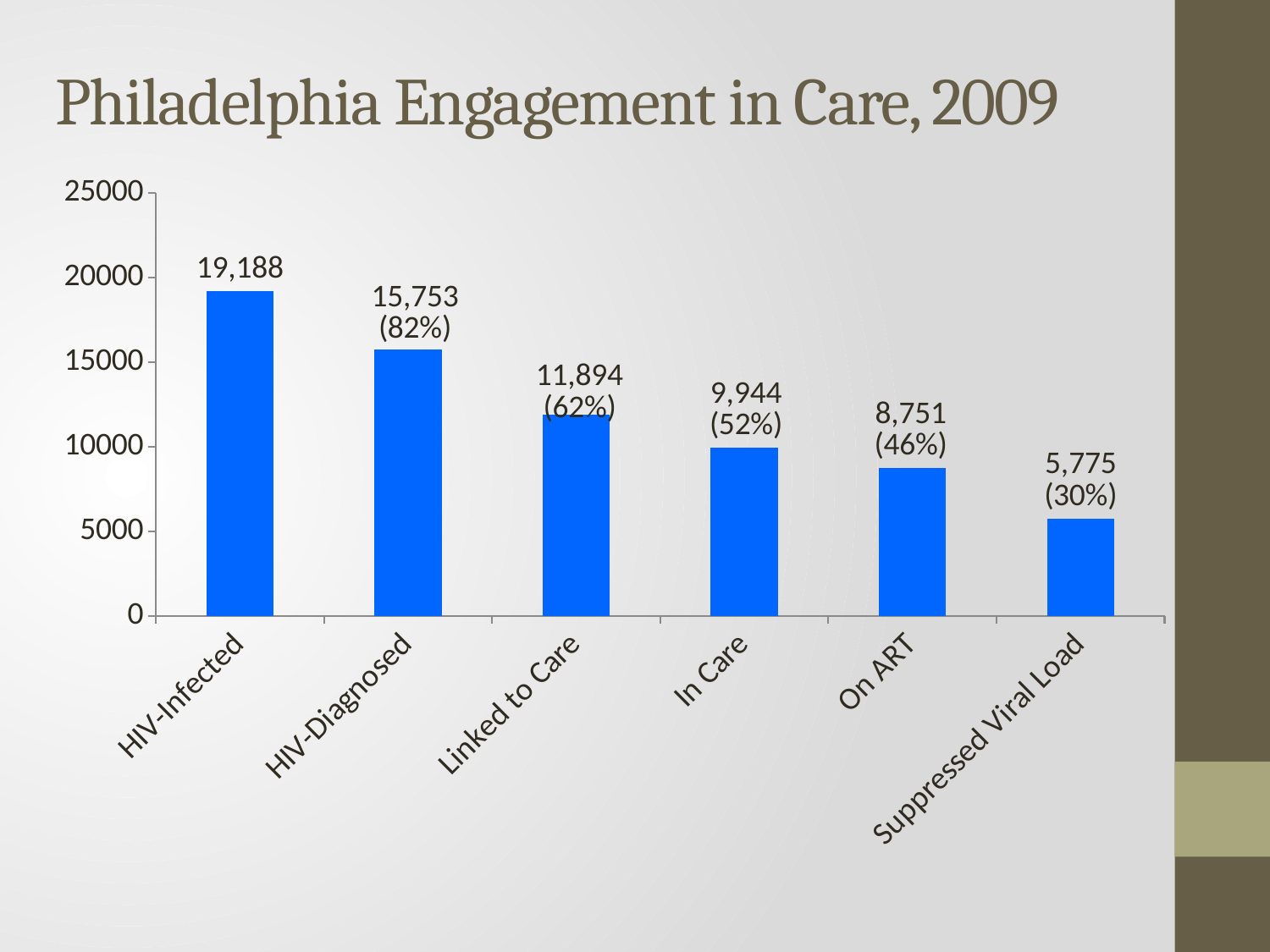
What percentage is shown for In Care? 52% What kind of chart is this? Bar chart Which category has the highest value? HIV-Infected Which is larger, the value for In Care or the value for On ART? In Care What is the difference between HIV-Infected and HIV-Diagnosed? 3,435 What is the value for Suppressed Viral Load? 5,775 (30%) What is the value for On ART? 8,751 (46%) How many categories are shown on the x axis? 6 What is the value for HIV-Infected? 19,188 What is the difference between Linked to Care and In Care? 1,950 Which category has the lowest value? Suppressed Viral Load Do the values rise or fall from left to right along the x axis? Fall